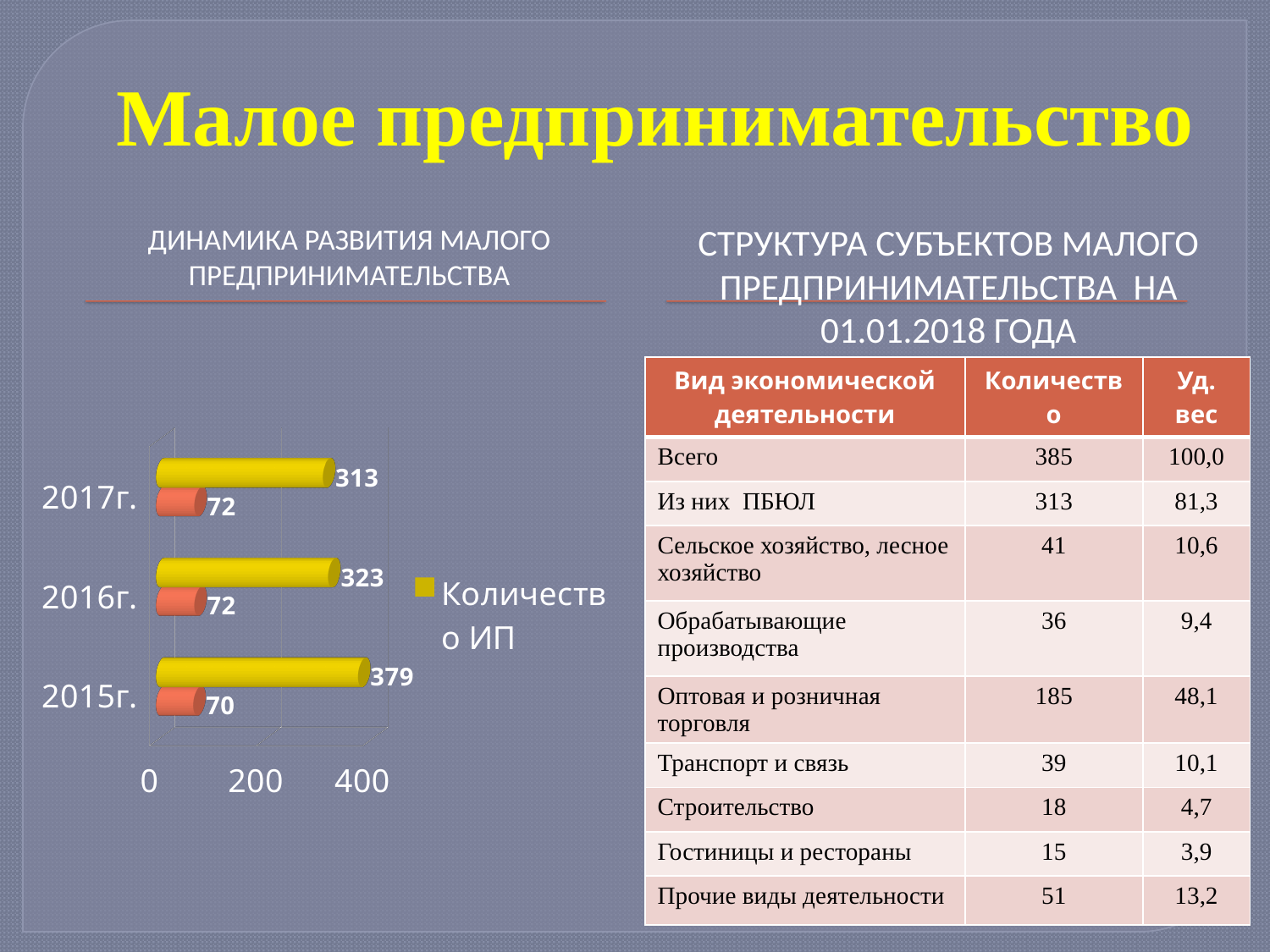
In the chart ДИНАМИКА РАЗВИТИЯ МАЛОГО ПРЕДПРИНИМАТЕЛЬСТВА, what is the value of Количество ИП for 2015г.? 379 In the chart ДИНАМИКА РАЗВИТИЯ МАЛОГО ПРЕДПРИНИМАТЕЛЬСТВА, what is the value of Количество ИП for 2017г.? 313 In the chart ДИНАМИКА РАЗВИТИЯ МАЛОГО ПРЕДПРИНИМАТЕЛЬСТВА, which year has the larger Количество ИП value, 2016г. or 2017г.? 2016г. In the chart ДИНАМИКА РАЗВИТИЯ МАЛОГО ПРЕДПРИНИМАТЕЛЬСТВА, what is the difference between the red bar values for 2017г. and 2015г.? 2 How many series entries does the legend of the chart ДИНАМИКА РАЗВИТИЯ МАЛОГО ПРЕДПРИНИМАТЕЛЬСТВА list? 1 In the chart ДИНАМИКА РАЗВИТИЯ МАЛОГО ПРЕДПРИНИМАТЕЛЬСТВА, what is the difference between the Количество ИП values for 2015г. and 2017г.? 66 In the chart ДИНАМИКА РАЗВИТИЯ МАЛОГО ПРЕДПРИНИМАТЕЛЬСТВА, does the value of Количество ИП rise or fall from 2015г. to 2017г.? Fall How many years (categories) are shown in the chart ДИНАМИКА РАЗВИТИЯ МАЛОГО ПРЕДПРИНИМАТЕЛЬСТВА? 3 In the chart ДИНАМИКА РАЗВИТИЯ МАЛОГО ПРЕДПРИНИМАТЕЛЬСТВА, what value is shown on the red bar for 2016г.? 72 In the chart ДИНАМИКА РАЗВИТИЯ МАЛОГО ПРЕДПРИНИМАТЕЛЬСТВА, which year has the highest value of Количество ИП? 2015г. What kind of chart is ДИНАМИКА РАЗВИТИЯ МАЛОГО ПРЕДПРИНИМАТЕЛЬСТВА? Bar chart In the chart ДИНАМИКА РАЗВИТИЯ МАЛОГО ПРЕДПРИНИМАТЕЛЬСТВА, which year has the lowest value of Количество ИП? 2017г.